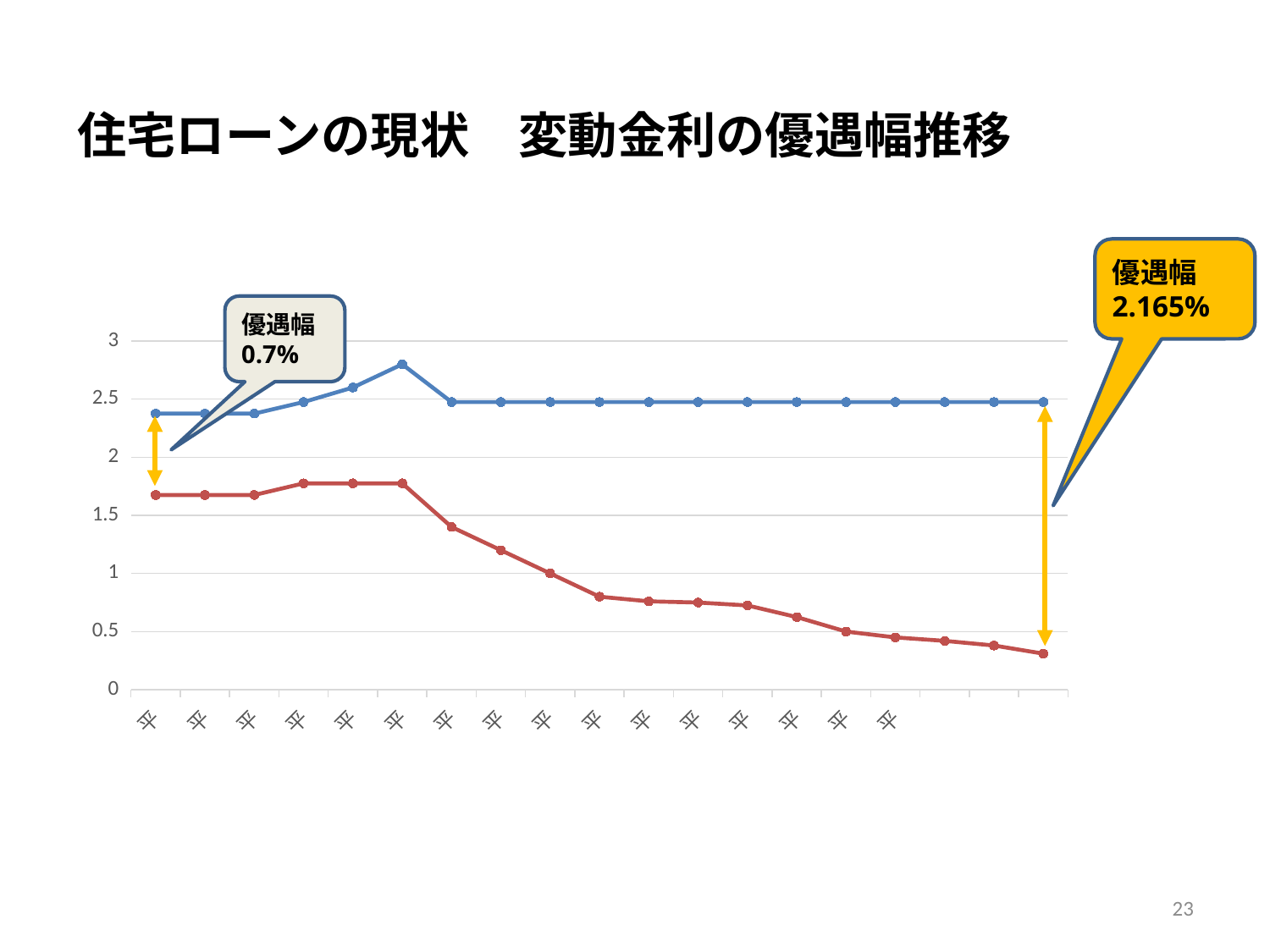
What kind of chart is shown on the slide? line chart Is the value of the red line at its last (rightmost) point greater or less than 0.5? less Does the red line rise or fall overall from left to right along the x axis? fall How many data points does the blue line have? 19 Which line is higher at the last point on the right, the blue line or the red line? blue line Is the highest value of the red line greater or less than 2? less What is the 優遇幅 value shown in the callout at the right (end) of the chart? 2.165% Is the value of the red line at its first (leftmost) point greater or less than 1.5? greater What is the title of the slide containing the chart? 住宅ローンの現状 変動金利の優遇幅推移 How many lines (series) are plotted on the chart? 2 What is the 優遇幅 value shown in the callout at the left (start) of the chart? 0.7%